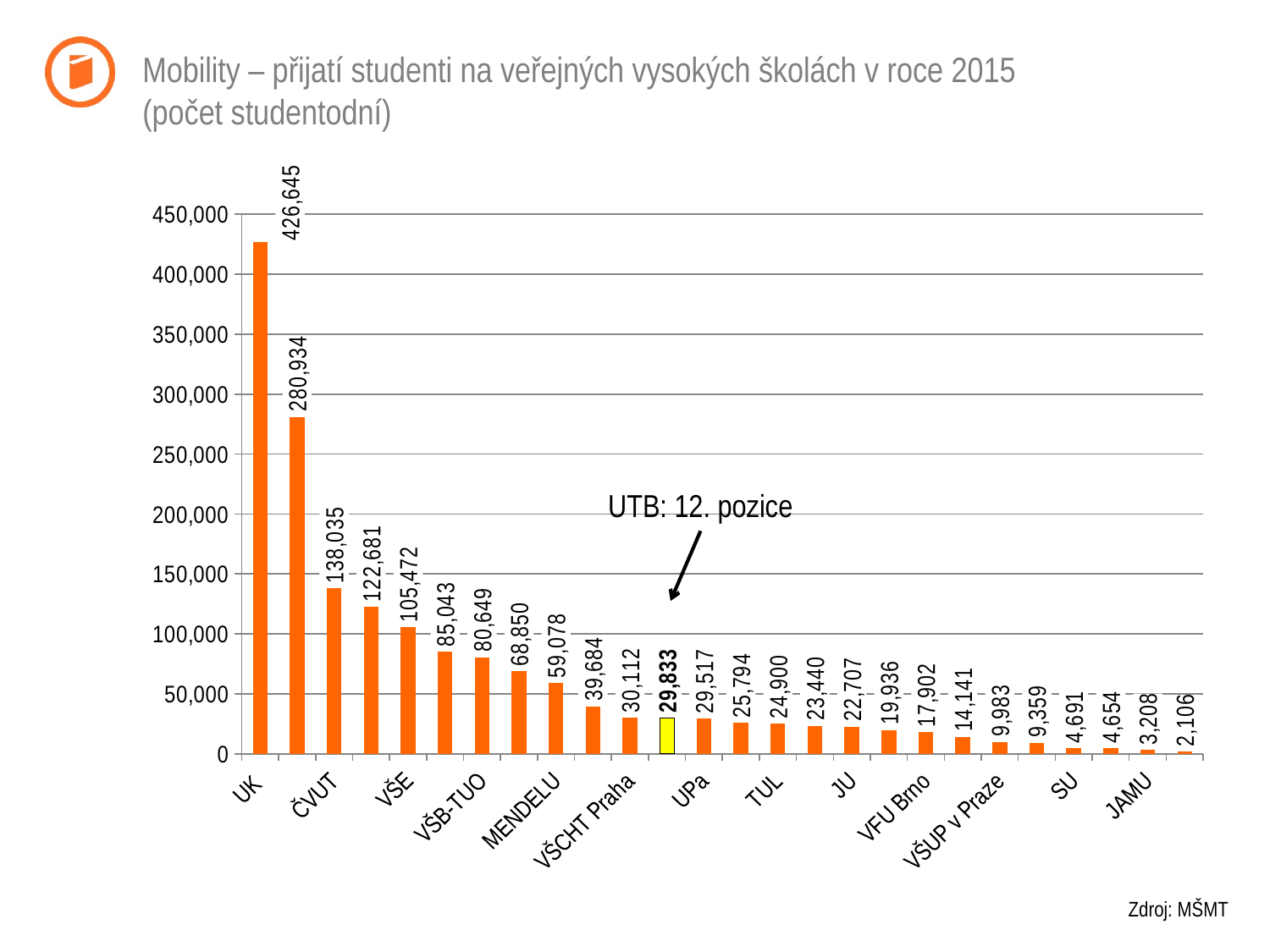
What is the difference between the values for UK and ČVUT? 288,610 What is the value for the highlighted UTB bar? 29,833 Which institution has the highest value? UK Is the value for VŠE greater or less than 100,000? greater What is the value for VŠCHT Praha? 30,112 What is the lowest value shown on the chart? 2,106 Which is larger, the value for VŠB-TUO or for MENDELU? VŠB-TUO How many bars are plotted on the chart? 26 What is the value for VŠE? 105,472 What is the difference between the values for VŠCHT Praha and UTB? 279 What is the value for UK? 426,645 What kind of chart is shown on the slide? bar chart